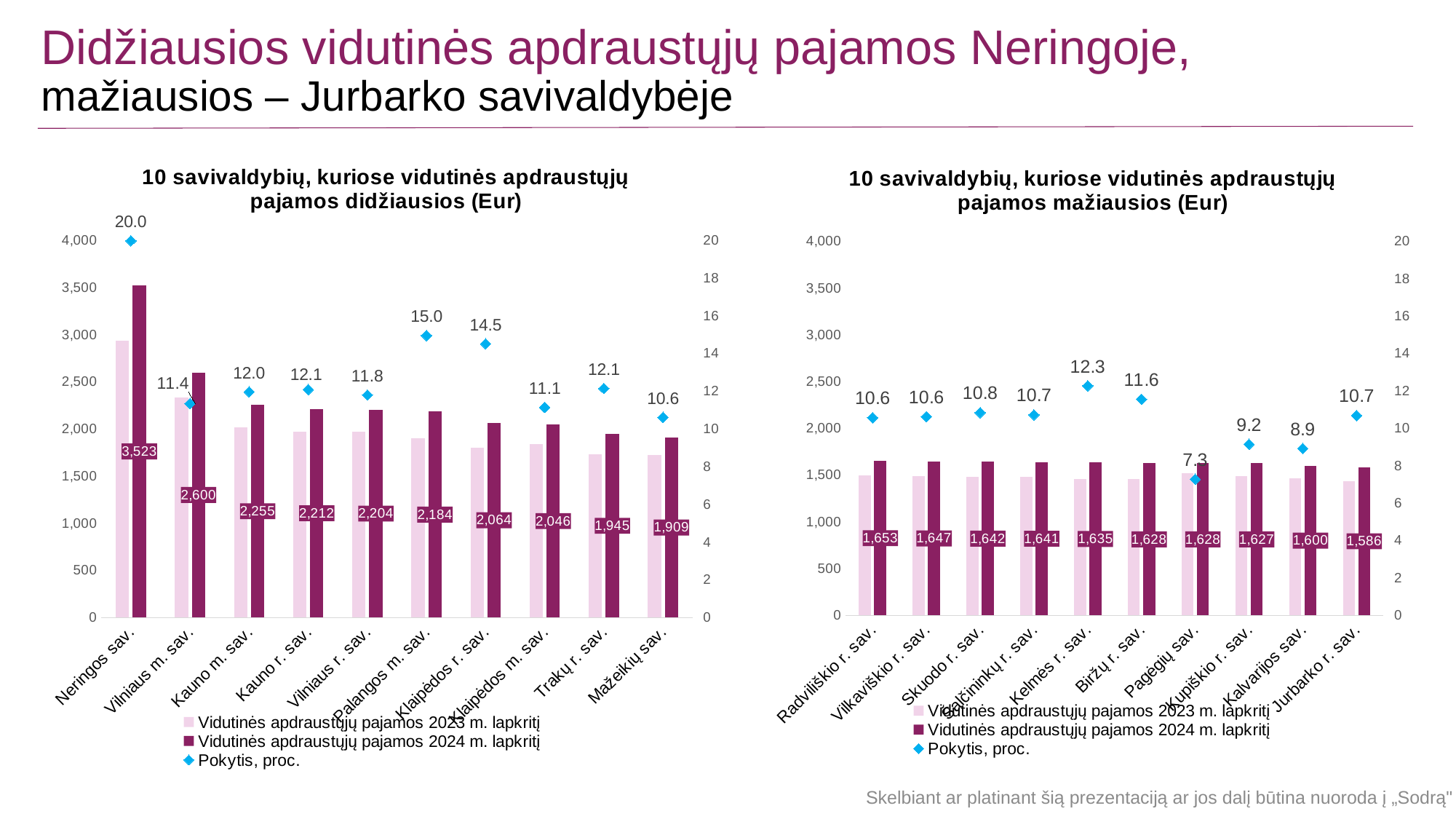
In the left chart (pajamos didžiausios), how many municipalities are shown on the x axis? 10 In the right chart (pajamos mažiausios), which is larger: the Pokytis, proc. for Kelmės r. sav. or for Kalvarijos sav.? Kelmės r. sav. In the right chart (pajamos mažiausios), what is the 2024 m. lapkritį value for Jurbarko r. sav.? 1,586 What kind of chart is the left chart (pajamos didžiausios)? Bar chart with a line/marker series How many series does the legend of the right chart (pajamos mažiausios) list? 3 In the right chart (pajamos mažiausios), which municipality has the lowest Pokytis, proc. value? Pagėgių sav. In the left chart (pajamos didžiausios), what is the 2024 m. lapkritį value for Neringos sav.? 3,523 In the left chart (pajamos didžiausios), what is the Pokytis, proc. value for Palangos m. sav.? 15.0 In the left chart (pajamos didžiausios), is the 2023 m. lapkritį value for Neringos sav. greater or less than 2,500? greater In the left chart (pajamos didžiausios), what is the difference between the 2024 values for Neringos sav. and Vilniaus m. sav.? 923 In the left chart (pajamos didžiausios), which municipality has the highest 2024 m. lapkritį value? Neringos sav. In the right chart (pajamos mažiausios), what is the difference between the 2024 values for Radviliškio r. sav. and Jurbarko r. sav.? 67